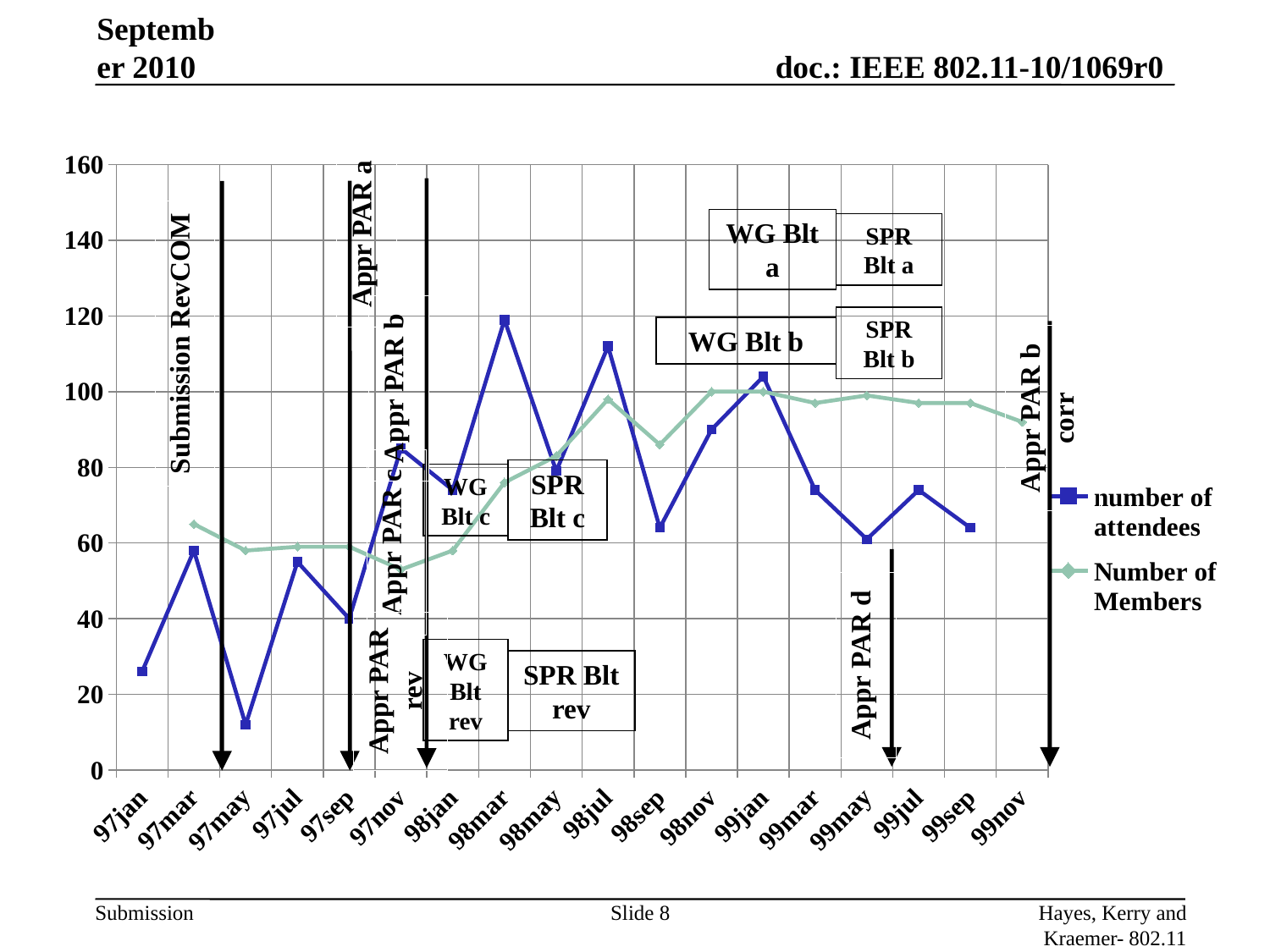
In which month is the number of attendees at its lowest? 97may In 99may, which is larger: the number of attendees or the Number of Members? Number of Members How many series does the chart legend list? 2 In which month does the number of attendees reach its highest value? 98mar Is the number of attendees in 98mar greater or less than 100? greater Is the number of attendees in 97may greater or less than 20? less In 98jul, which is larger: the number of attendees or the Number of Members? number of attendees How many month labels are shown along the x axis? 18 What kind of chart is shown on the slide? line chart Is the Number of Members in 98nov greater or less than 80? greater What are the two series named in the legend? number of attendees; Number of Members